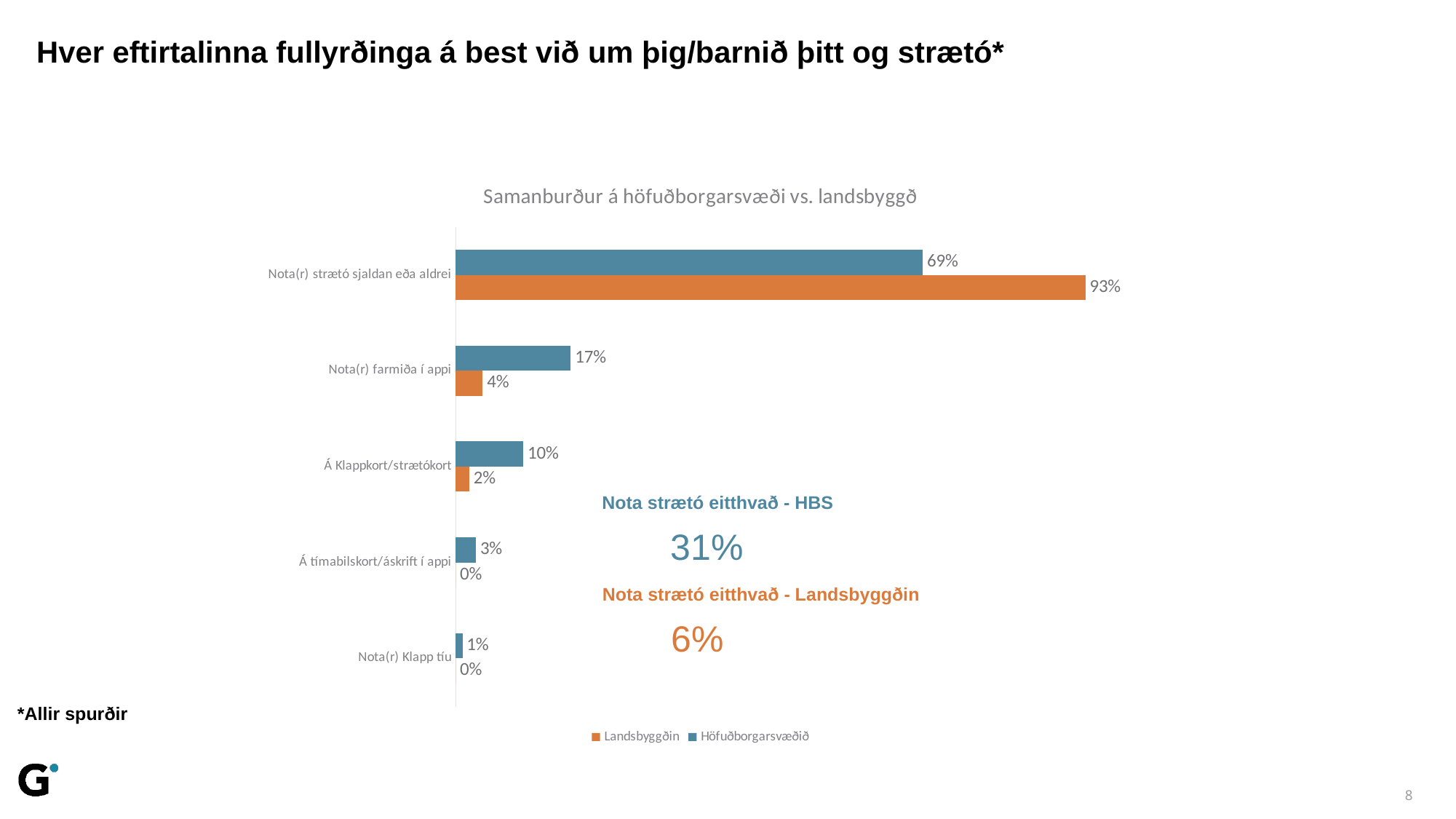
Which category has the highest Höfuðborgarsvæðið value? Nota(r) strætó sjaldan eða aldrei What is the Landsbyggðin value for "Nota(r) strætó sjaldan eða aldrei"? 93% What is the difference between the Landsbyggðin and Höfuðborgarsvæðið values for "Nota(r) strætó sjaldan eða aldrei"? 24% What is the title of the chart? Samanburður á höfuðborgarsvæði vs. landsbyggð What kind of chart is shown on the slide? Bar chart How many categories are shown on the chart? 5 What is the Höfuðborgarsvæðið value for "Nota(r) farmiða í appi"? 17% For "Nota(r) farmiða í appi", which series has the larger value, Landsbyggðin or Höfuðborgarsvæðið? Höfuðborgarsvæðið What is the Landsbyggðin value for "Á Klappkort/strætókort"? 2% How many series does the legend list? 2 What is the Höfuðborgarsvæðið value for "Nota(r) Klapp tíu"? 1% Which category has the lowest Höfuðborgarsvæðið value? Nota(r) Klapp tíu